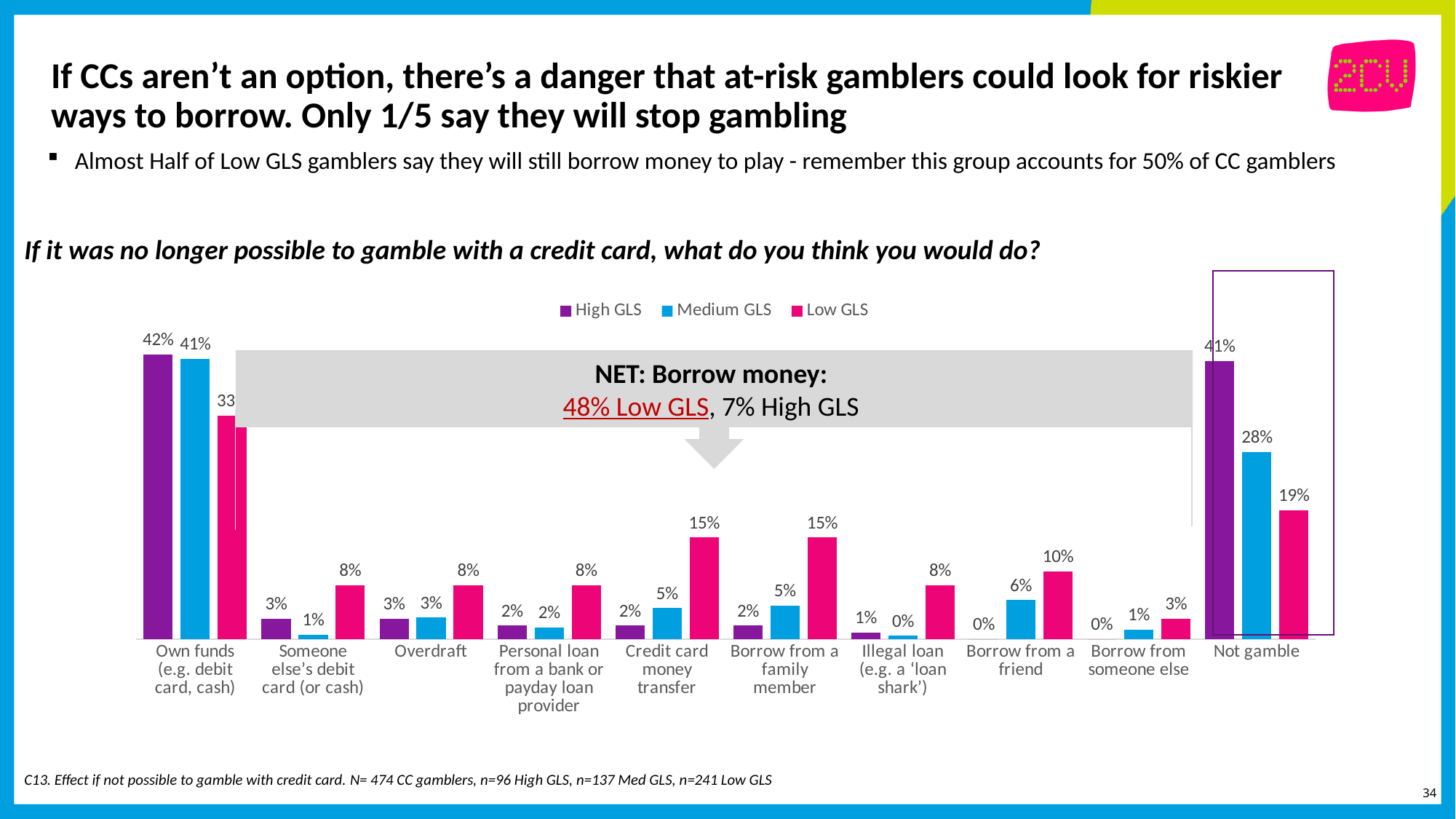
How many categories are shown on the x axis of the chart? 10 How many series does the chart legend list? 3 Which category has the highest Medium GLS value? Own funds (e.g. debit card, cash) For 'Credit card money transfer', how much higher is the Low GLS value than the High GLS value? 13 percentage points Which category has the lowest Low GLS value? Borrow from someone else What is the High GLS value for 'Own funds (e.g. debit card, cash)'? 42% What is the Low GLS value for 'Credit card money transfer'? 15% What is the Medium GLS value for 'Not gamble'? 28% For 'Not gamble', what is the difference between the High GLS and Low GLS values? 22 percentage points What is the Low GLS value for 'Illegal loan (e.g. a 'loan shark')'? 8% What type of chart is shown on the slide? Bar chart For 'Borrow from a friend', which is larger: the Medium GLS value or the Low GLS value? Low GLS